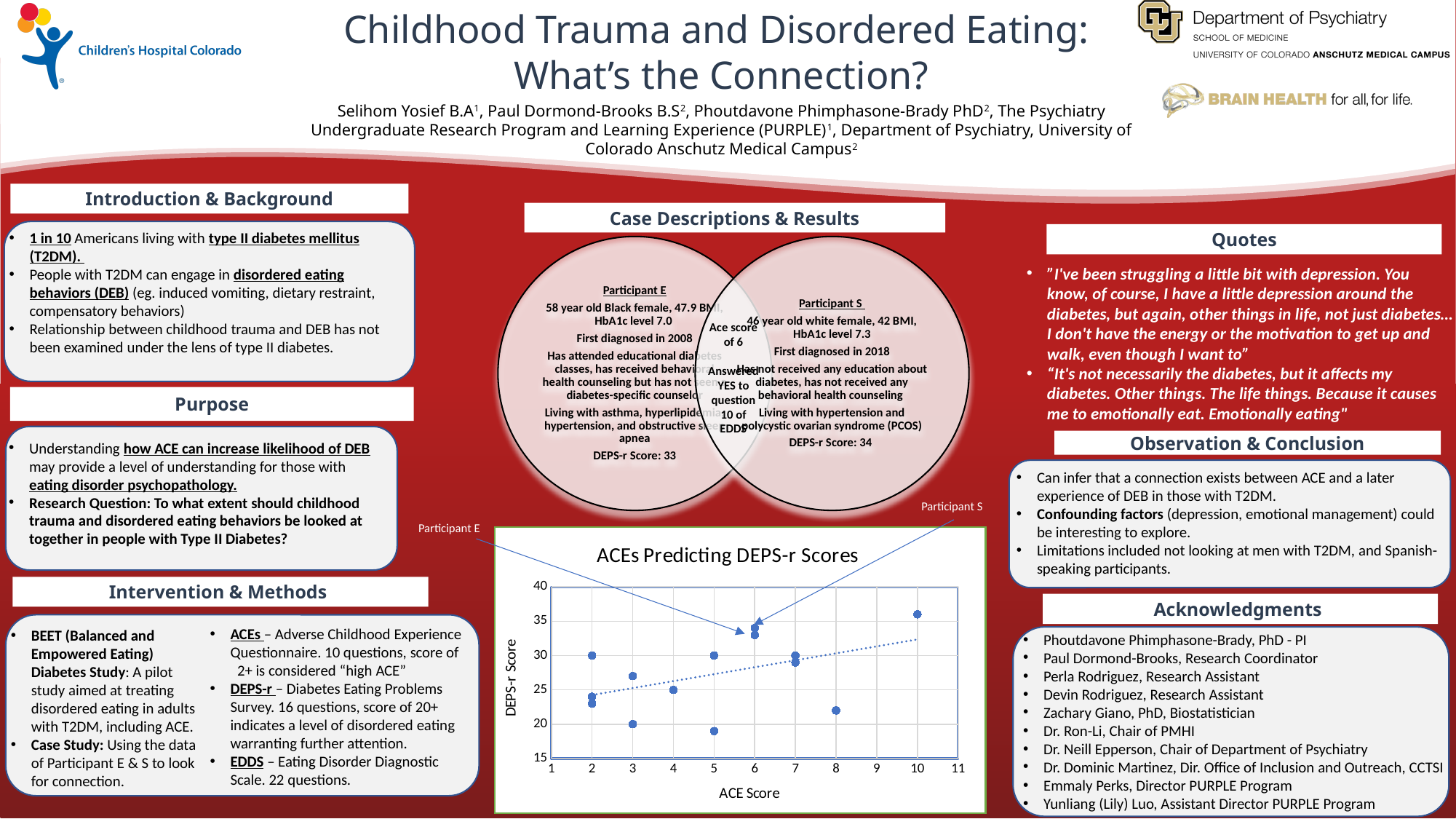
What is the highest ACE score at which a point is plotted in the chart? 10 Do DEPS-r scores generally rise or fall as ACE score increases along the x axis, according to the trend line? rise In the chart, is the DEPS-r score for the point at ACE score 10 larger than the DEPS-r score for the point at ACE score 8? yes What is the title of the chart on the slide? ACEs Predicting DEPS-r Scores In the chart, is the DEPS-r score for the point at ACE score 8 greater or less than 25? less What is the label of the x axis of the chart? ACE Score In the chart, is the DEPS-r score for the point at ACE score 4 greater or less than 30? less In the chart, is the DEPS-r score for the point at ACE score 10 greater or less than 35? greater What kind of chart is 'ACEs Predicting DEPS-r Scores'? scatter chart Which ACE score has the highest DEPS-r score plotted in the chart? 10